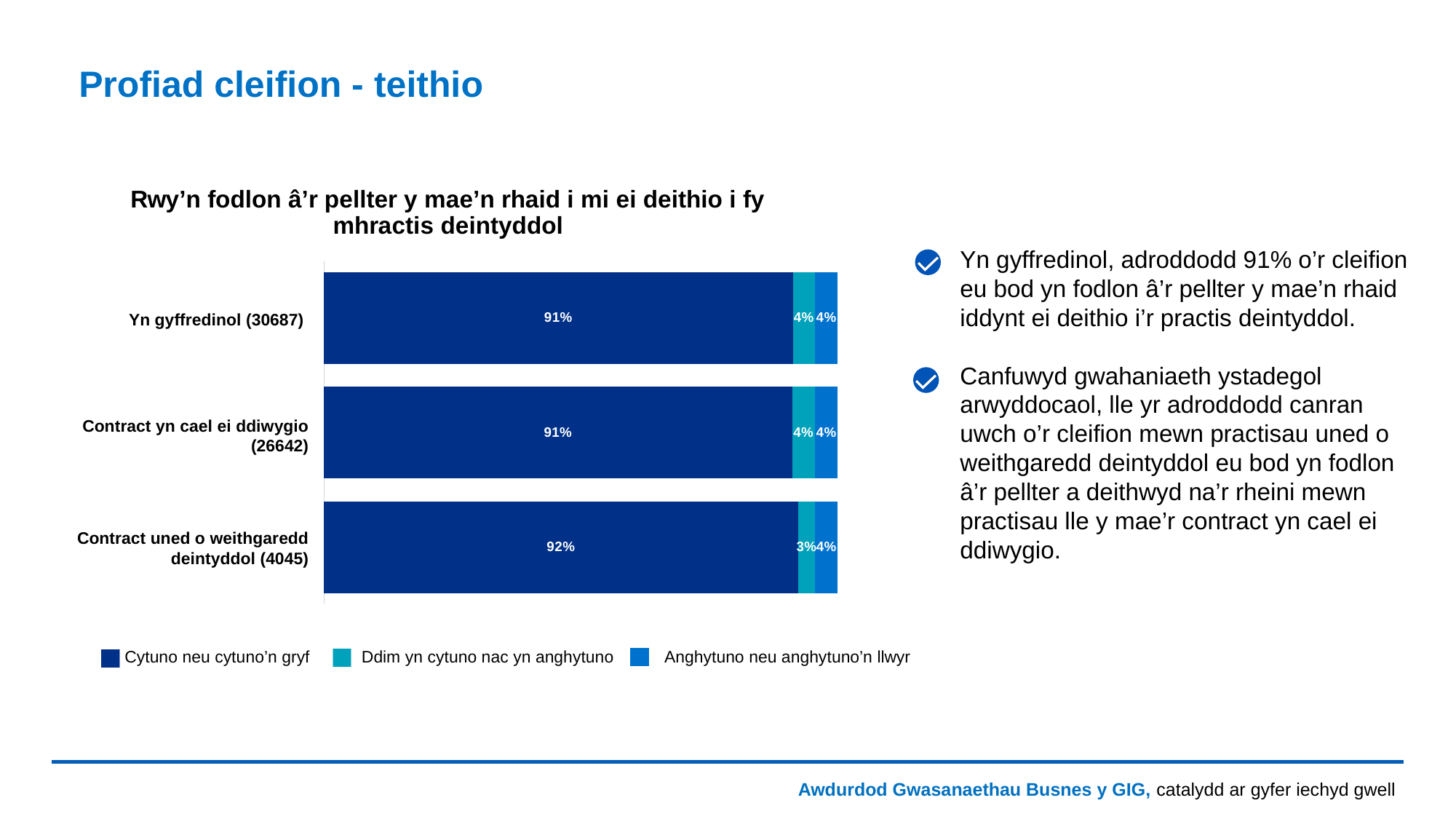
What is the 'Anghytuno neu anghytuno'n llwyr' value for 'Contract yn cael ei ddiwygio (26642)'? 4% How many series does the legend list? 3 What is the 'Ddim yn cytuno nac yn anghytuno' value for 'Contract uned o weithgaredd deintyddol (4045)'? 3% Which category has the highest 'Cytuno neu cytuno'n gryf' value? Contract uned o weithgaredd deintyddol (4045) What is the difference between the 'Cytuno neu cytuno'n gryf' values for 'Contract uned o weithgaredd deintyddol (4045)' and 'Yn gyffredinol (30687)'? 1% Which category has the lowest 'Ddim yn cytuno nac yn anghytuno' value? Contract uned o weithgaredd deintyddol (4045) How many categories are shown in the chart? 3 What type of chart is shown on the slide? Stacked bar chart Which is larger: the 'Cytuno neu cytuno'n gryf' value for 'Contract uned o weithgaredd deintyddol (4045)' or for 'Contract yn cael ei ddiwygio (26642)'? Contract uned o weithgaredd deintyddol (4045) What is the 'Cytuno neu cytuno'n gryf' value for 'Yn gyffredinol (30687)'? 91% What is the 'Cytuno neu cytuno'n gryf' value for 'Contract uned o weithgaredd deintyddol (4045)'? 92% What is the total of the labelled segments in the bar for 'Yn gyffredinol (30687)'? 99%